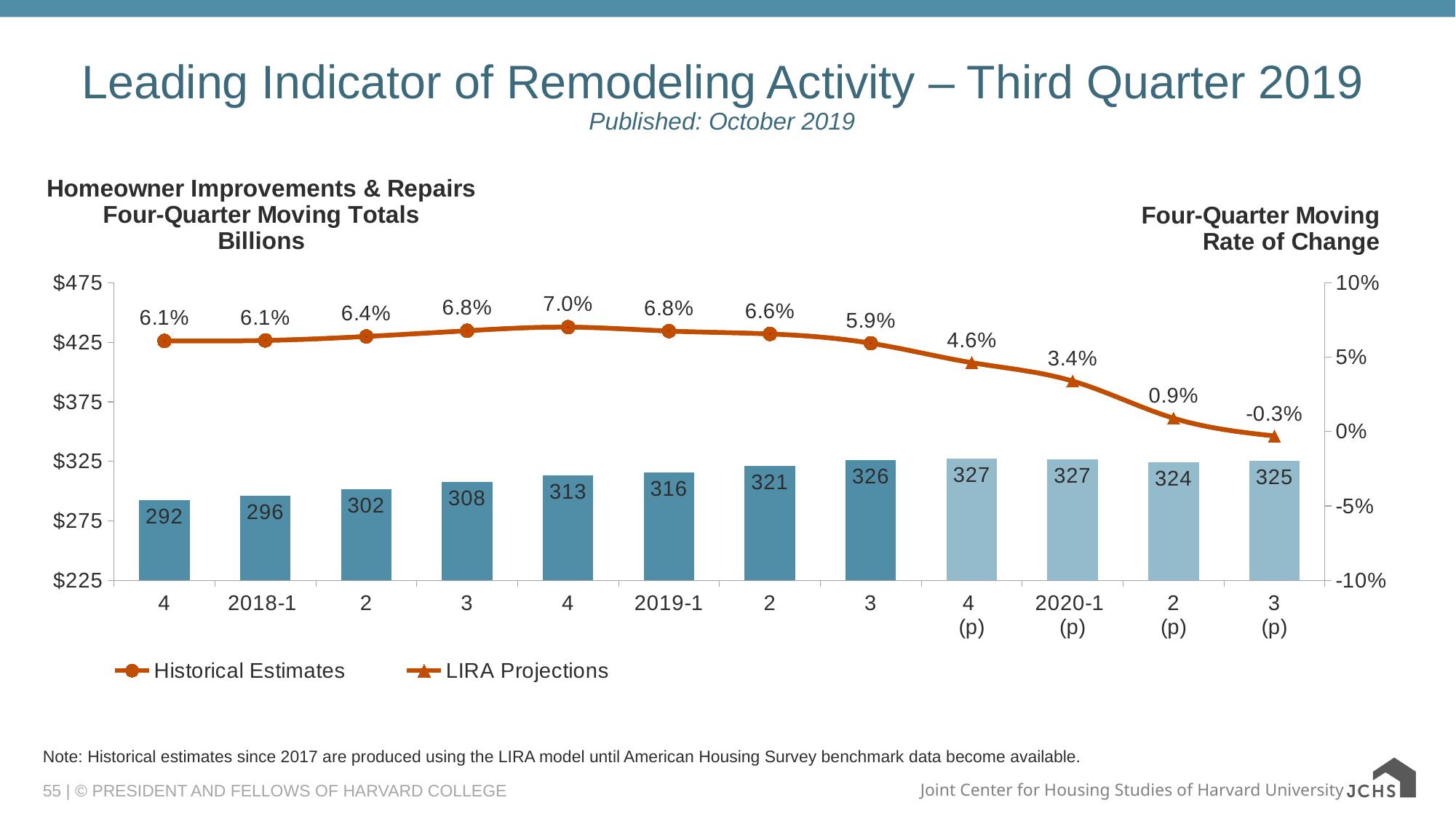
What is the difference in four-quarter moving totals between 2019-3 and 2018-1? 30 What is the four-quarter moving total (in billions) for 2019-1? 316 Which is larger, the four-quarter moving total for 2019-2 or for 2020-2 (p)? 2020-2 (p) How many quarters are plotted on the x axis? 12 Which quarter has the lowest four-quarter moving total in billions? 4 (2017) Is the four-quarter moving rate of change for 2020-3 (p) greater or less than 0%? less What is the four-quarter moving rate of change for quarter 4 of 2018? 7.0% Does the four-quarter moving rate of change rise or fall from 2019-1 to 2020-3 (p)? fall What is the four-quarter moving rate of change for 2020-1 (p)? 3.4% How many series does the legend list? 2 Which quarter has the highest four-quarter moving rate of change? 4 (2018) What are the two series named in the legend? Historical Estimates and LIRA Projections